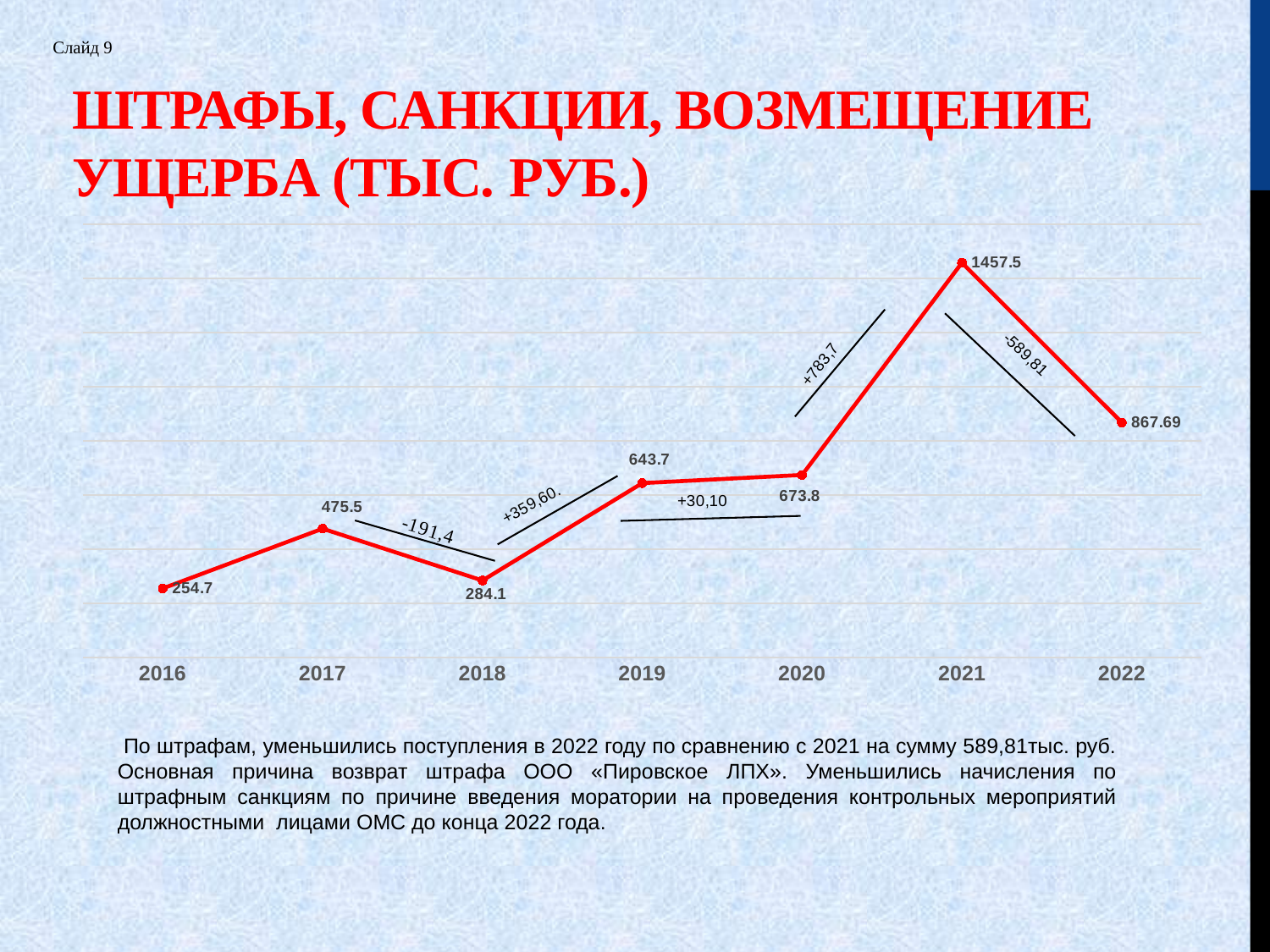
What is the value for 2016? 254.7 Which year has the highest value? 2021 What is the difference between the values for 2017 and 2018? 191.4 What kind of chart is shown on the slide? line chart What is the value for 2019? 643.7 Which year has the lowest value? 2016 What is the value for 2021? 1457.5 Which is larger, the value for 2019 or the value for 2020? 2020 What is the value for 2022? 867.69 What is the difference between the values for 2021 and 2022? 589.81 Does the value rise or fall from 2021 to 2022? fall How many years are plotted on the chart? 7